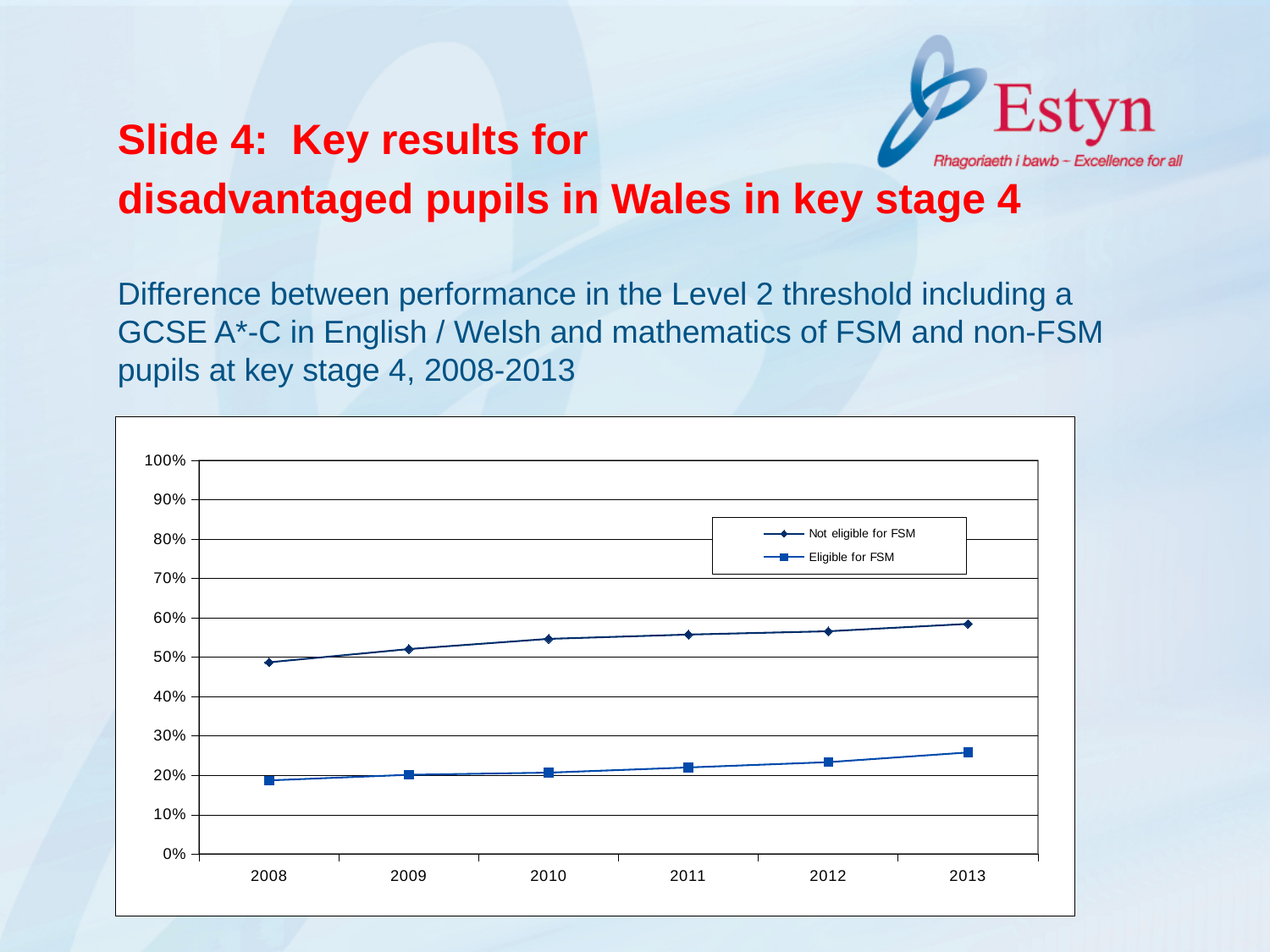
Is the value for 'Eligible for FSM' in 2013 greater or less than 20%? greater How many years are plotted along the x axis of the chart? 6 In which year is the 'Eligible for FSM' value lowest? 2008 How many series does the chart's legend list? 2 Does the 'Eligible for FSM' line rise or fall from 2008 to 2013? rise What kind of chart is shown on the slide? line chart In which year is the 'Not eligible for FSM' value highest? 2013 Is the value for 'Eligible for FSM' in 2008 greater or less than 30%? less Does the 'Not eligible for FSM' line rise or fall from 2008 to 2013? rise In 2011, which series has the larger value, 'Not eligible for FSM' or 'Eligible for FSM'? Not eligible for FSM Which two series are listed in the chart's legend? Not eligible for FSM; Eligible for FSM Is the value for 'Not eligible for FSM' in 2013 greater or less than 50%? greater